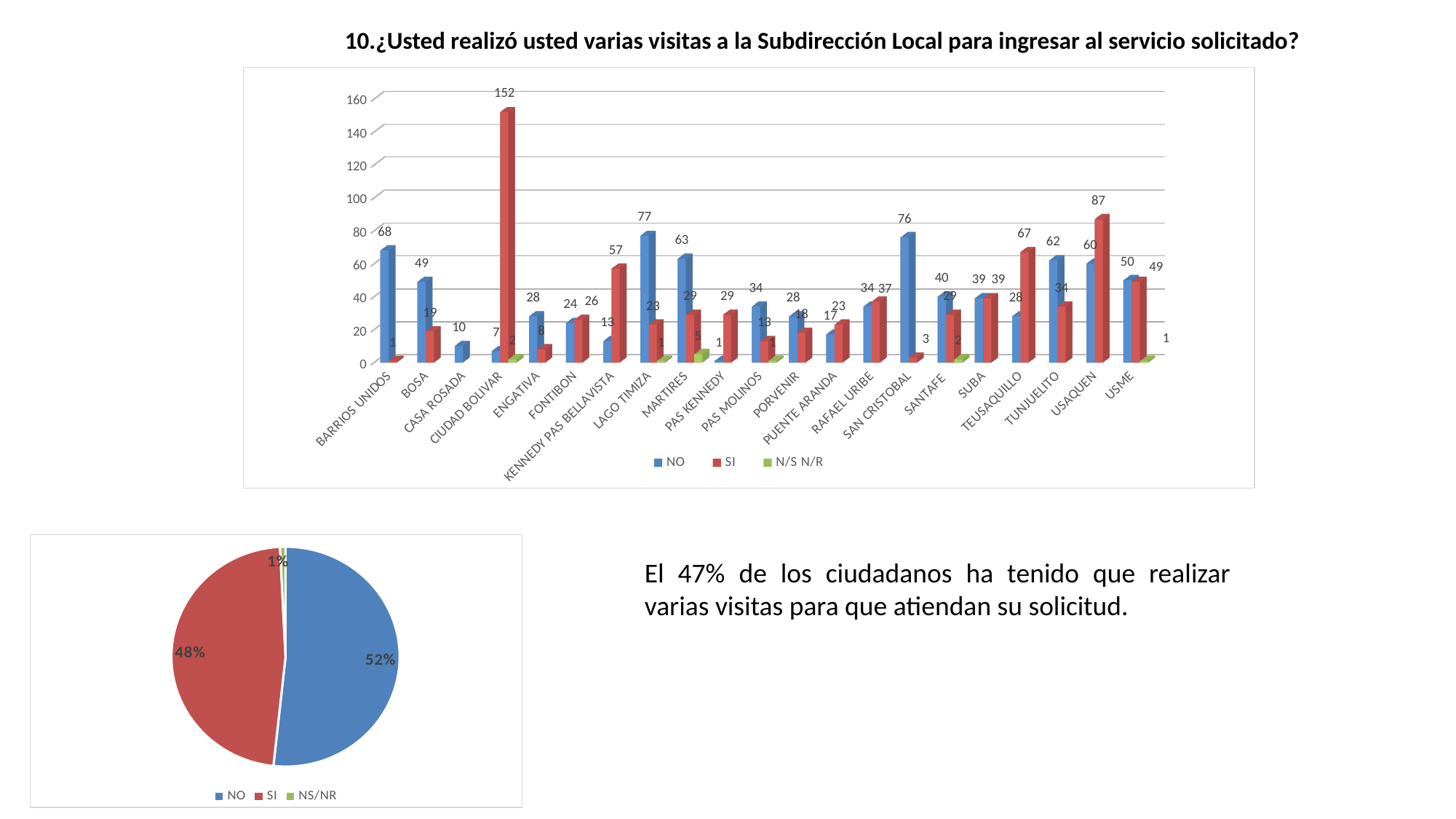
How many categories are shown on the x axis of the bar chart? 21 In the pie chart, what share does the SI slice have? 48% In the pie chart, which slice is the largest? NO In the bar chart, which category has the highest SI value? CIUDAD BOLIVAR What kind of chart is the chart at the bottom left of the slide? Pie chart In the bar chart, what is the NO value for LAGO TIMIZA? 77 In the bar chart, which category has the highest NO value? LAGO TIMIZA In the bar chart, what is the difference between the NO and SI values for SAN CRISTOBAL? 73 How many series does the legend of the bar chart list? 3 In the bar chart, which is larger for TEUSAQUILLO, the NO value or the SI value? SI In the bar chart, what is the SI value for CIUDAD BOLIVAR? 152 In the bar chart, what is the SI value for USAQUEN? 87